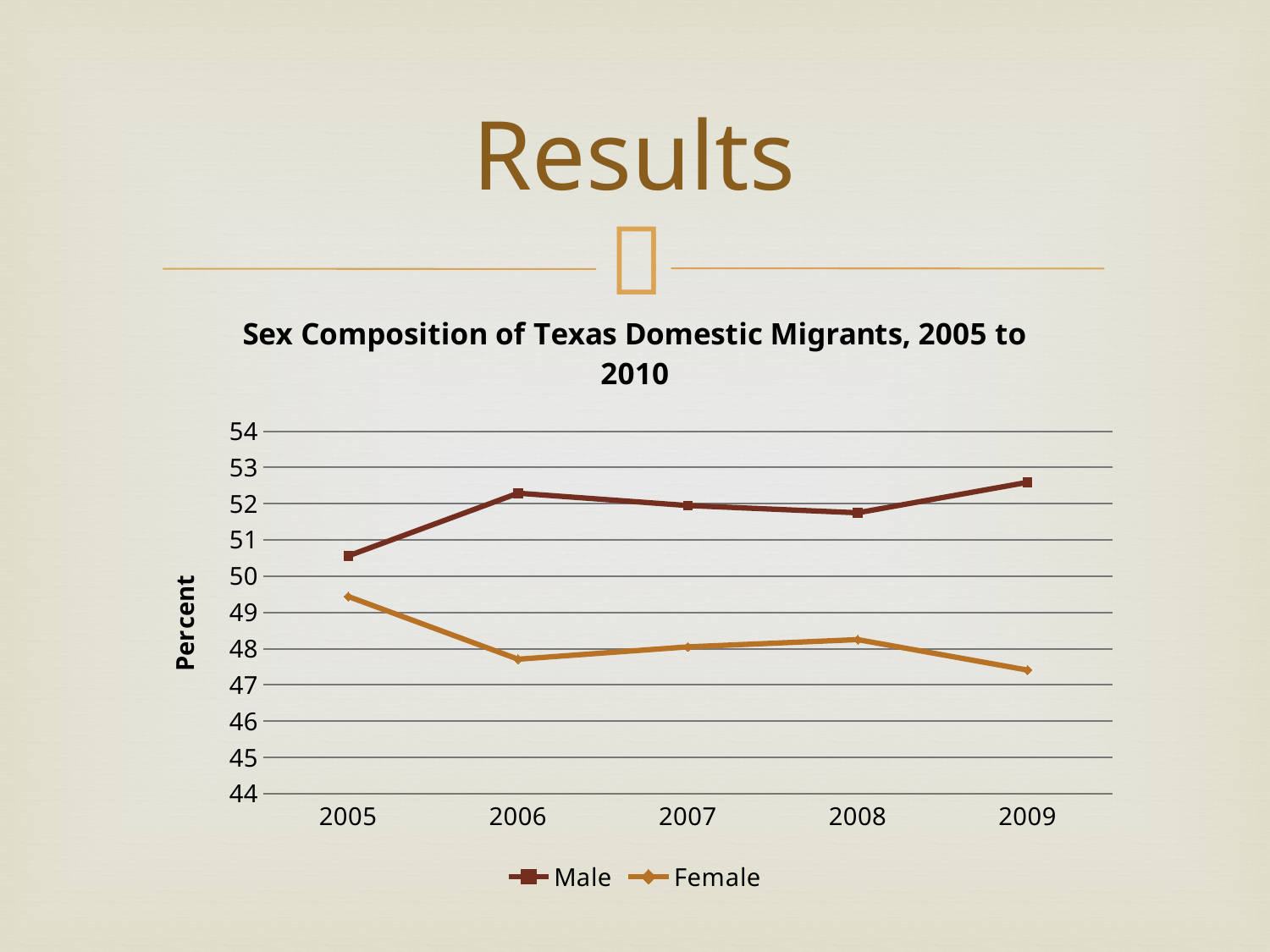
Does the Female line rise or fall from 2005 to 2006? fall How many years are plotted along the x axis? 5 Is the Male value for 2005 greater or less than 50? greater Is the Male value for 2009 greater or less than 52? greater Is the Female value for 2006 greater or less than 48? less In which year is the Female value highest? 2005 In which year is the Male value lowest? 2005 What kind of chart is shown on the slide? line chart How many series does the legend list? 2 What is the title of the chart? Sex Composition of Texas Domestic Migrants, 2005 to 2010 In 2007, which series has the larger value, Male or Female? Male